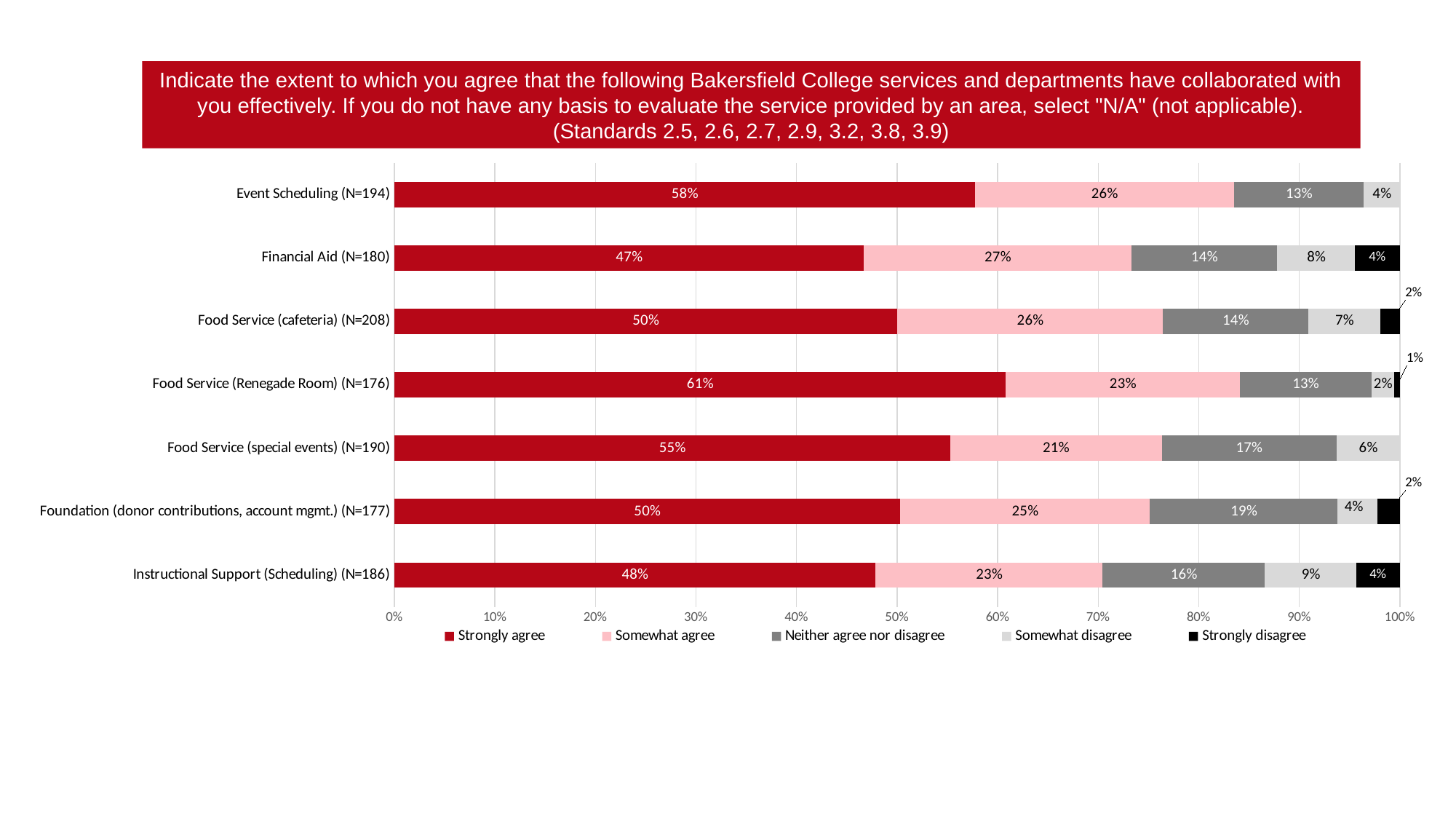
Which department has the highest Strongly agree percentage? Food Service (Renegade Room) (N=176) What type of chart is shown on the slide? Stacked bar chart What is the Neither agree nor disagree value for Foundation (donor contributions, account mgmt.) (N=177)? 19% What is the difference between the Strongly agree percentages for Event Scheduling (N=194) and Financial Aid (N=180)? 11% Which department has the lowest Strongly agree percentage? Financial Aid (N=180) Which colour represents Strongly disagree in the chart? Black What is the Somewhat disagree value for Instructional Support (Scheduling) (N=186)? 9% Which has a larger Neither agree nor disagree share: Food Service (special events) (N=190) or Food Service (cafeteria) (N=208)? Food Service (special events) (N=190) What is the Somewhat agree value for Financial Aid (N=180)? 27% How many response categories does the legend list? 5 How many departments or services are shown in the chart? 7 What percentage of respondents strongly agree for Food Service (Renegade Room) (N=176)? 61%